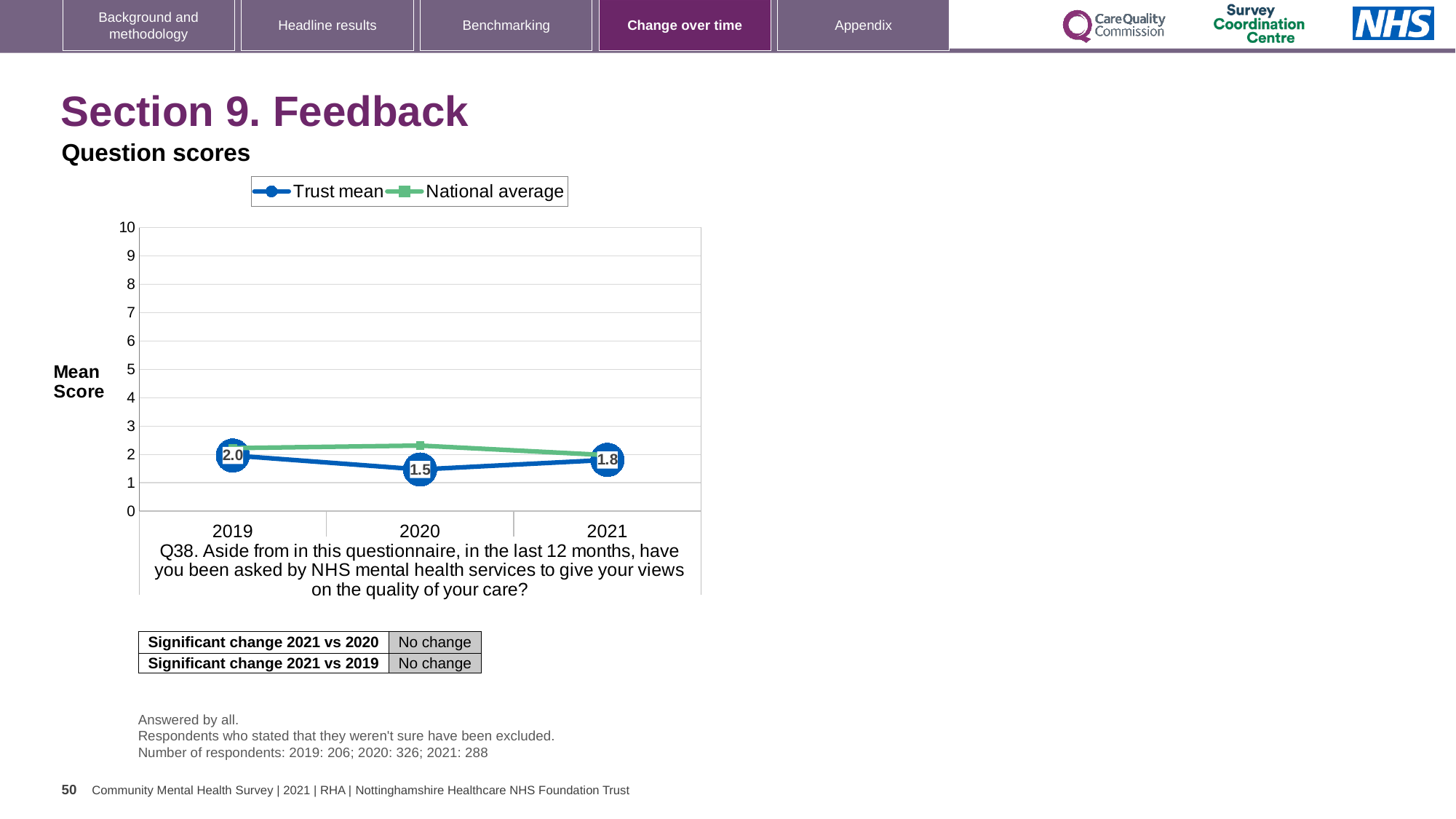
How many years are plotted on the x axis of the chart? 3 In which year was the Trust mean score highest? 2019 What is the difference between the Trust mean scores for 2019 and 2020? 0.5 What is the Trust mean score for 2019? 2.0 Is the National average for 2019 greater or less than 2? greater What is the Trust mean score for 2020? 1.5 How many series does the chart legend list? 2 In which year was the Trust mean score lowest? 2020 Did the Trust mean rise or fall from 2019 to 2020? fall What is the Trust mean score for 2021? 1.8 In 2020, which is higher: the Trust mean or the National average? National average What type of chart is shown on the slide? line chart